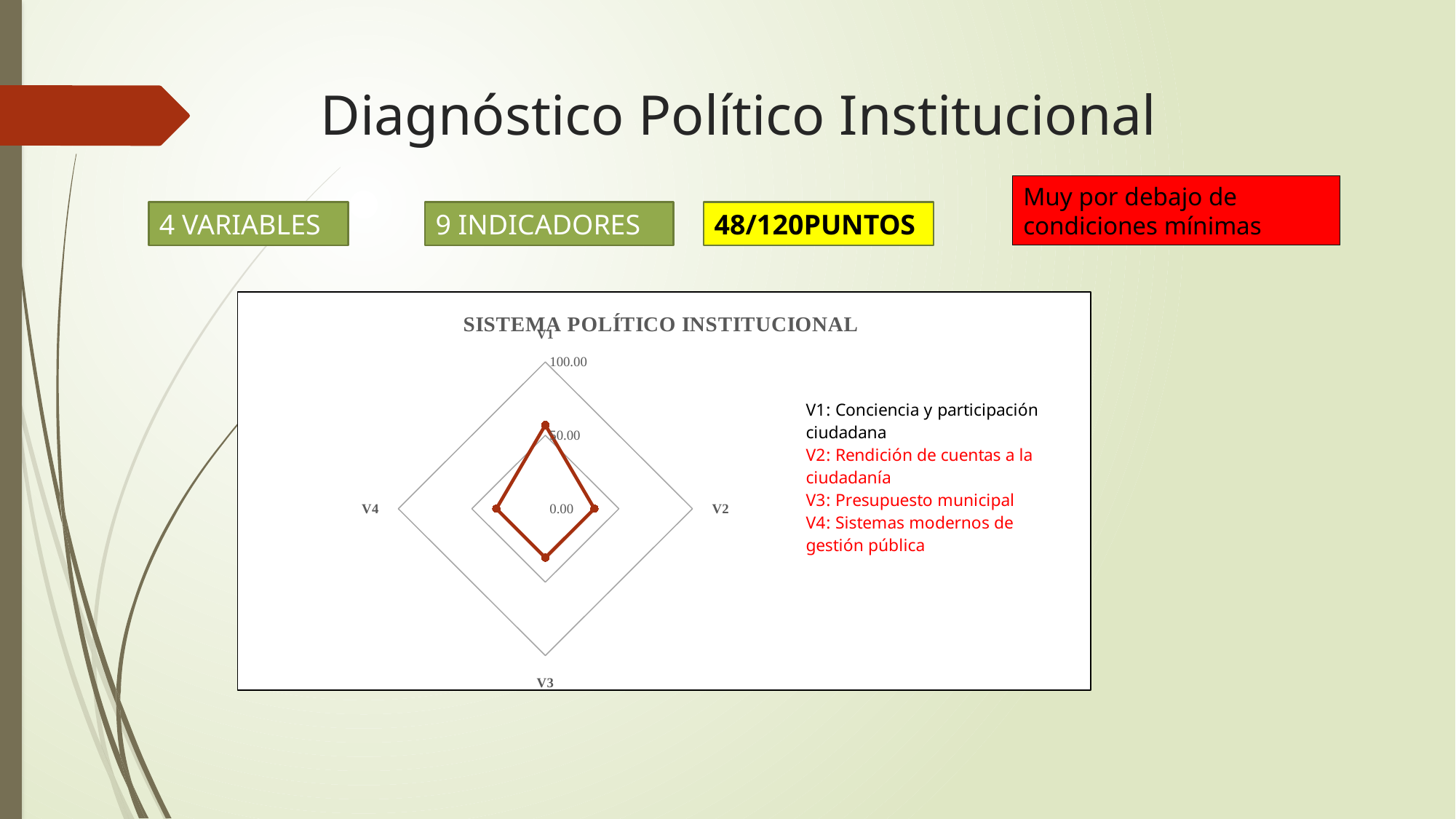
Is the value for V1 greater or less than 100.00? less Which variable has the highest value on the radar chart? V1 What is the title of the chart? SISTEMA POLÍTICO INSTITUCIONAL Which is larger, the value for V1 or the value for V2? V1 Is the value for V4 greater or less than 50.00? less Which is larger, the value for V1 or the value for V3? V1 Is the value for V3 greater or less than 50.00? less How many axes (variables) does the radar chart have? 4 What is the maximum value shown on the radar chart's axis scale? 100.00 What kind of chart is shown on the slide? Radar chart